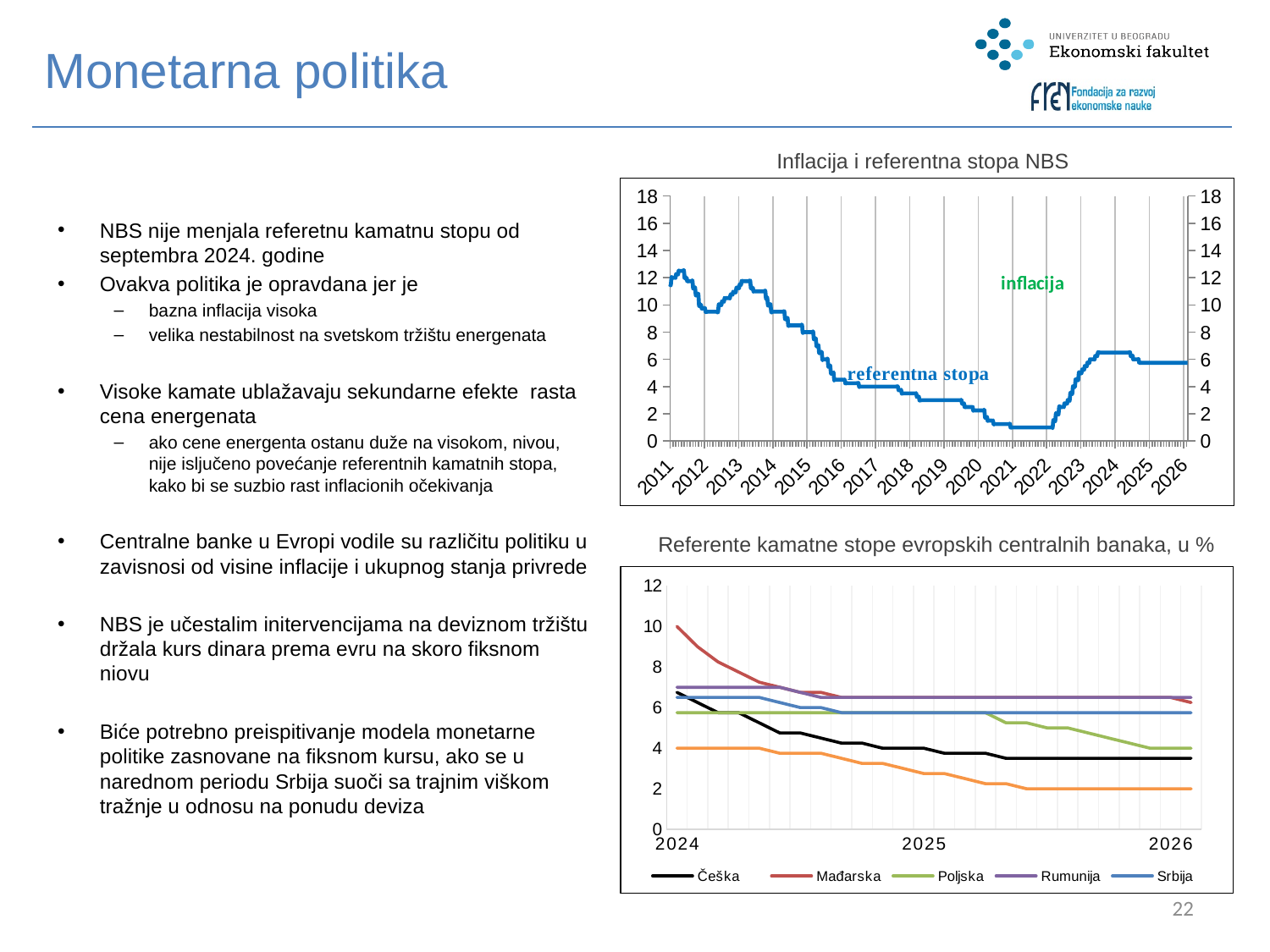
In the bottom chart 'Referente kamatne stope evropskih centralnih banaka, u %', is the value for Mađarska at the start of 2024 greater or less than 8? greater What type of chart is the top chart titled 'Inflacija i referentna stopa NBS'? line chart In the bottom chart 'Referente kamatne stope evropskih centralnih banaka, u %', which is larger at 2026: Rumunija or Češka? Rumunija In the bottom chart 'Referente kamatne stope evropskih centralnih banaka, u %', which country has the highest rate at the start of 2024? Mađarska What type of chart is the bottom chart 'Referente kamatne stope evropskih centralnih banaka, u %'? line chart In the bottom chart 'Referente kamatne stope evropskih centralnih banaka, u %', how many series does the legend list? 5 In the bottom chart 'Referente kamatne stope evropskih centralnih banaka, u %', is the value for Češka at 2026 greater or less than 4? less In the top chart 'Inflacija i referentna stopa NBS', how many series are plotted? 2 In the top chart 'Inflacija i referentna stopa NBS', is the referentna stopa value in 2024 greater or less than 4? greater